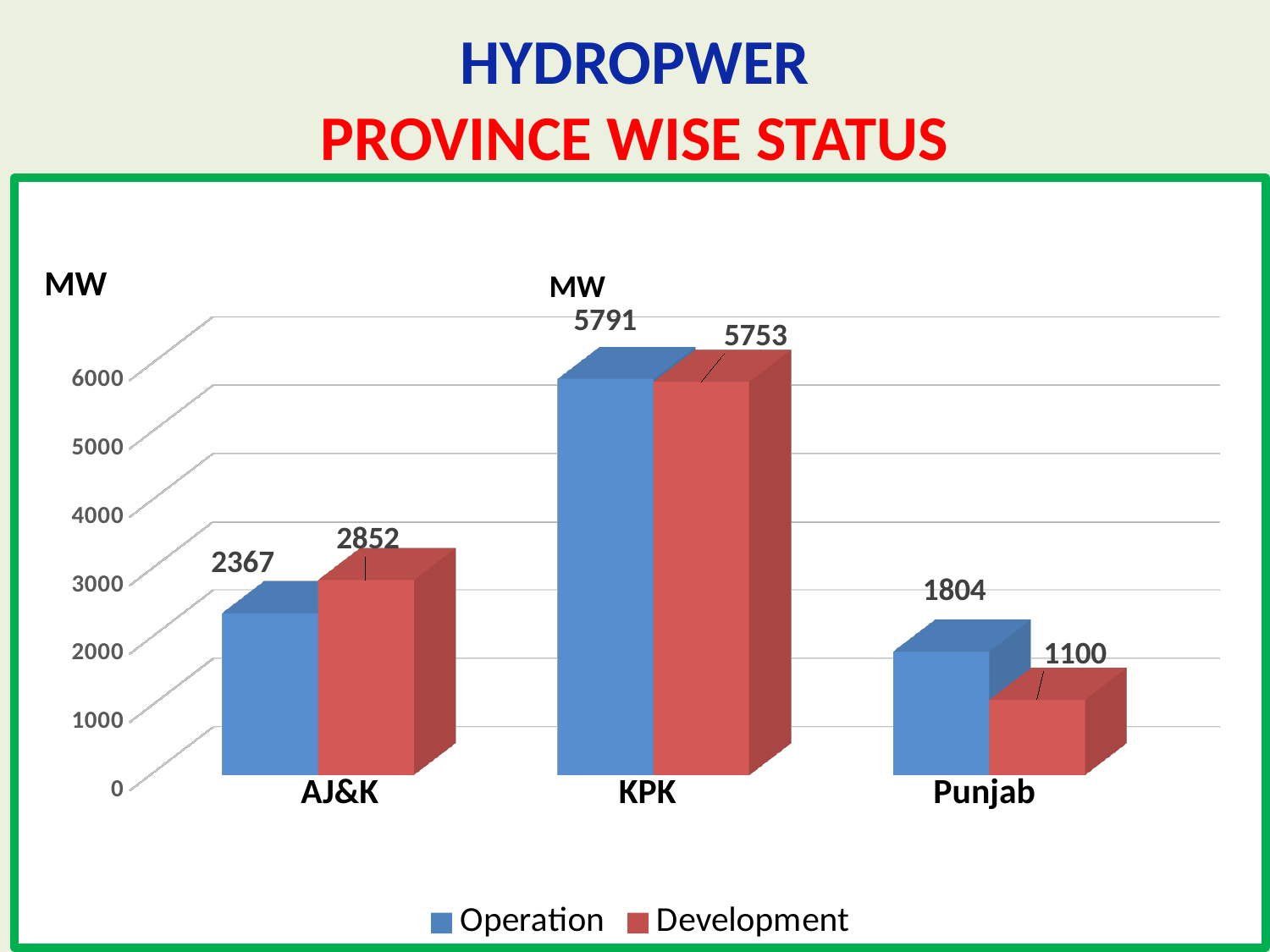
What is the Development value for Punjab? 1100 Which province has the highest Operation value? KPK What kind of chart is shown on the slide? Bar chart What is the difference between the Development values for KPK and AJ&K? 2901 For AJ&K, which is larger: the Operation value or the Development value? Development Which province has the lowest Development value? Punjab How many provinces are shown on the x axis? 3 Which colour represents the Development series? Red How many series does the legend list? 2 What is the Development value for AJ&K? 2852 What is the Operation value for KPK? 5791 What is the difference between the Operation and Development values for Punjab? 704